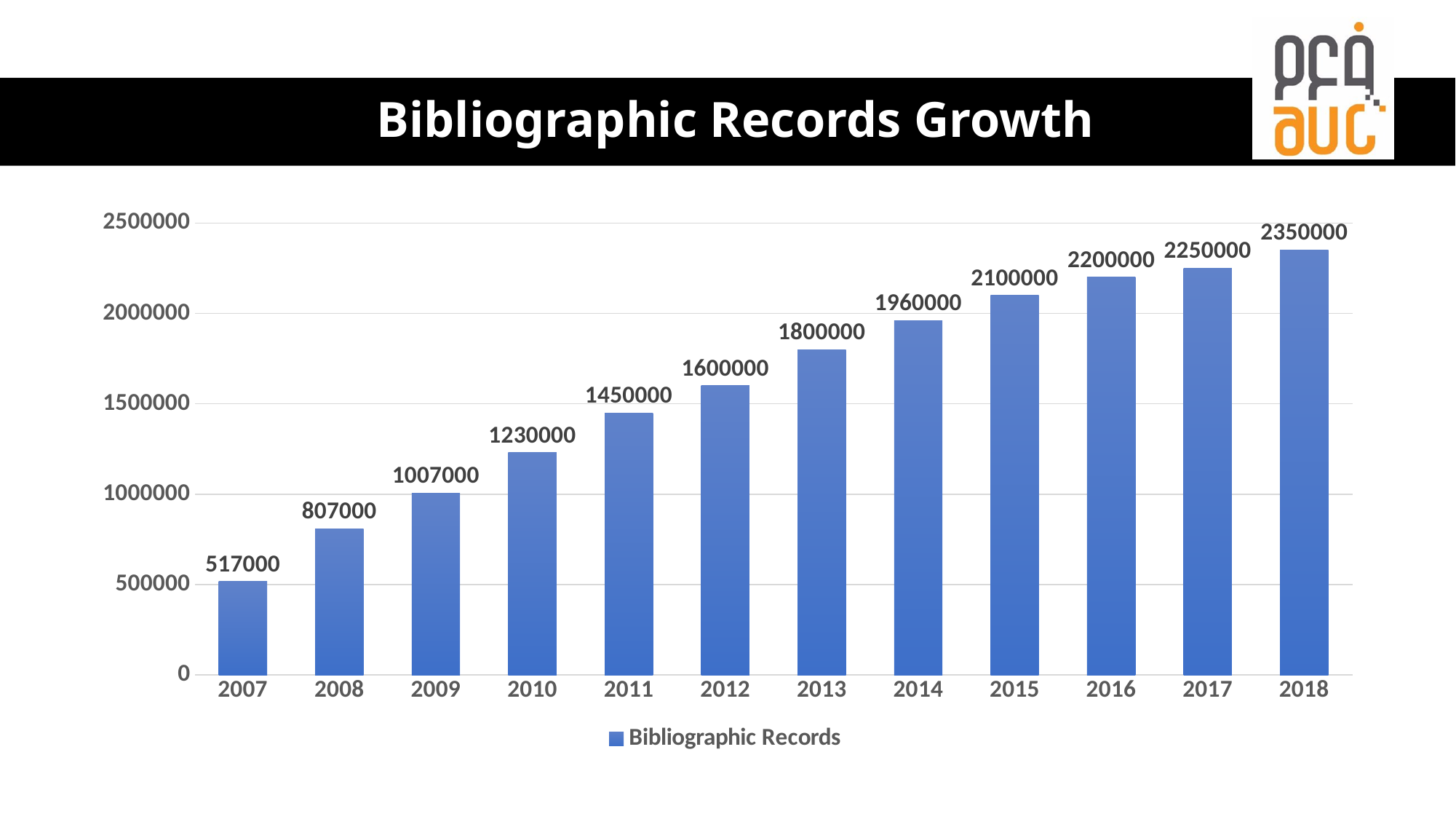
What is the difference in Bibliographic Records between 2018 and 2017? 100000 Is the value for 2014 greater or less than 2000000? less Which year has the lowest number of Bibliographic Records? 2007 What is the difference in Bibliographic Records between 2009 and 2008? 200000 What is the value of Bibliographic Records for 2007? 517000 What is the value of Bibliographic Records for 2010? 1230000 Which year has more Bibliographic Records, 2011 or 2012? 2012 How many years are shown on the x axis? 12 Do the Bibliographic Records values rise or fall from 2007 to 2018? Rise Which year has the highest number of Bibliographic Records? 2018 What is the value of Bibliographic Records for 2013? 1800000 What type of chart is shown on the slide? Bar chart